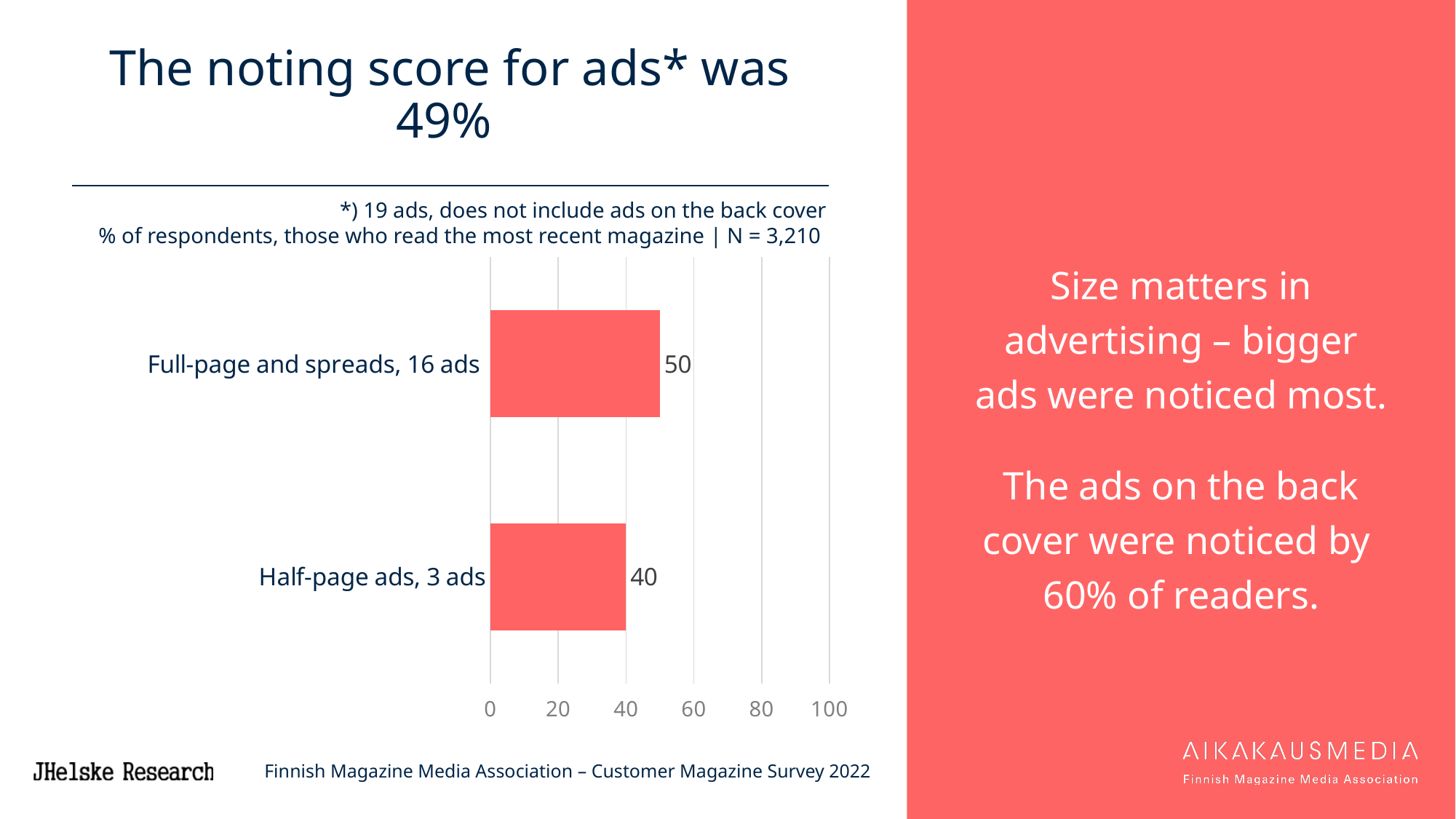
What is the value for Half-page ads, 3 ads? 40 Is the value for Half-page ads, 3 ads greater or less than 20? greater Which is larger: the value for Full-page and spreads, 16 ads or the value for Half-page ads, 3 ads? Full-page and spreads, 16 ads Is the value for Full-page and spreads, 16 ads greater or less than 60? less Which category has the lowest value? Half-page ads, 3 ads What is the maximum value shown on the chart's axis? 100 What is the difference between the values for Full-page and spreads, 16 ads and Half-page ads, 3 ads? 10 What is the sample size (N) stated above the chart? 3,210 Which category has the highest value? Full-page and spreads, 16 ads What kind of chart is shown on the slide? bar chart How many categories are shown in the chart? 2 What is the value for Full-page and spreads, 16 ads? 50